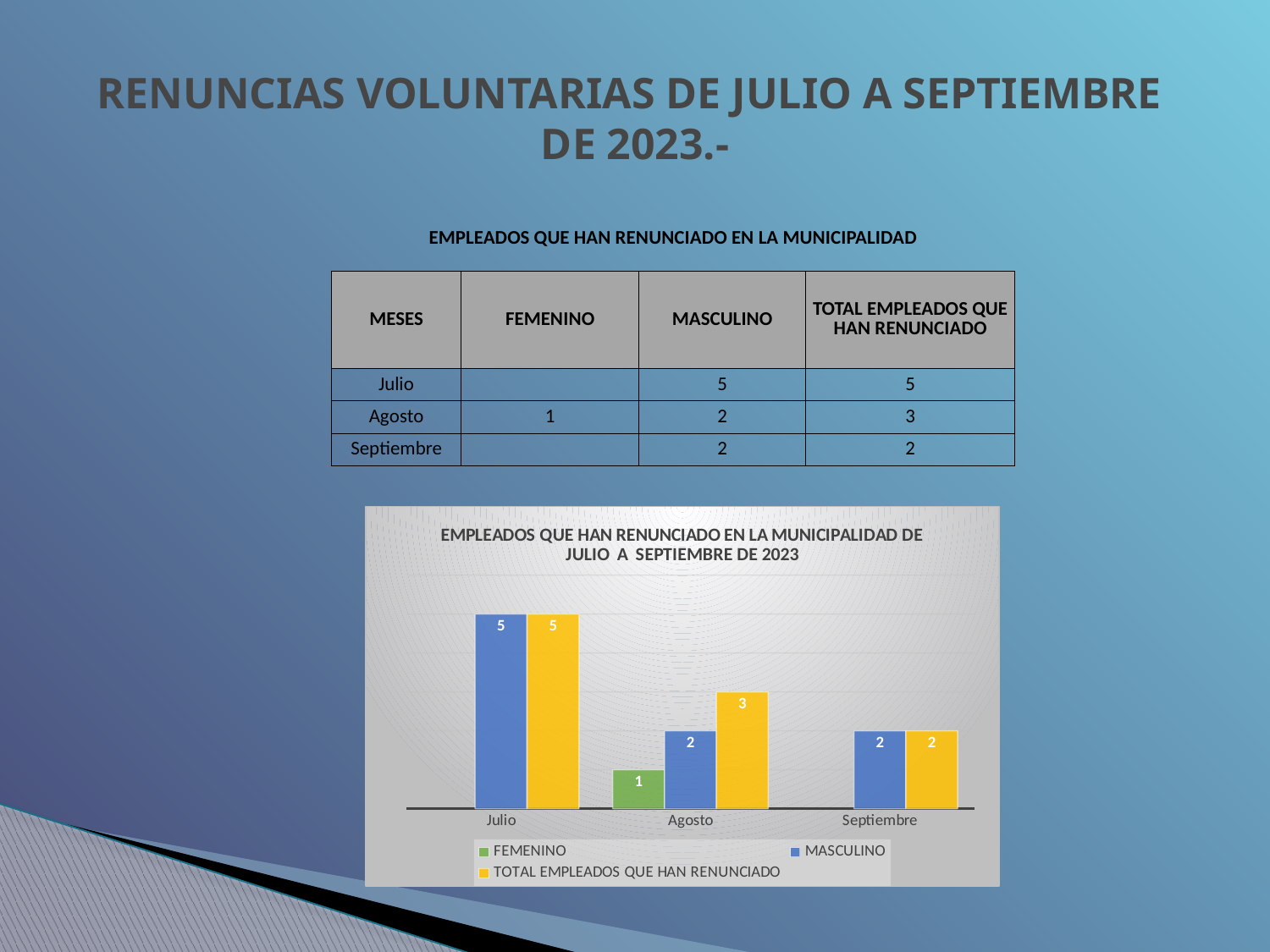
What is the MASCULINO value for Septiembre? 2 How many months are shown on the x axis of the chart? 3 Do the TOTAL EMPLEADOS QUE HAN RENUNCIADO values rise or fall from Julio to Septiembre? Fall Which month has the lowest TOTAL EMPLEADOS QUE HAN RENUNCIADO value? Septiembre What kind of chart is shown on the slide? Bar chart How many series does the chart legend list? 3 What is the MASCULINO value for Julio? 5 Which month has the highest TOTAL EMPLEADOS QUE HAN RENUNCIADO value? Julio What is the difference between the MASCULINO values for Julio and Agosto? 3 Which is larger, the TOTAL EMPLEADOS QUE HAN RENUNCIADO value for Agosto or for Septiembre? Agosto What is the FEMENINO value for Agosto? 1 What is the TOTAL EMPLEADOS QUE HAN RENUNCIADO value for Agosto? 3